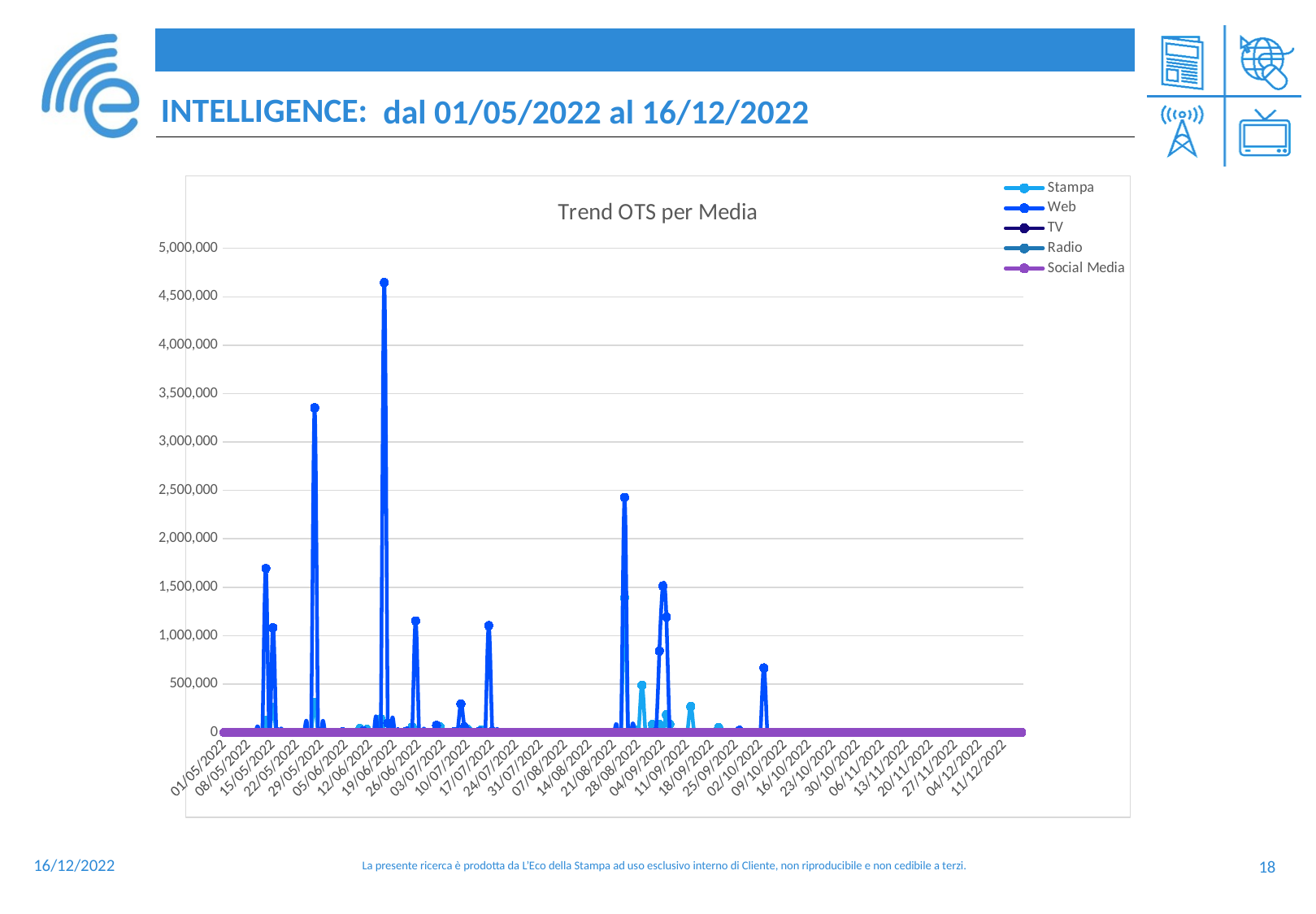
What is the title of the chart? Trend OTS per Media Is the highest peak of the Web series (around 19/06/2022) greater or less than 4,000,000? greater Is the Web peak around 28/08/2022 greater or less than 2,000,000? greater Is the Web peak around 22/05/2022 greater or less than 3,000,000? greater Which is larger: the Web peak around 19/06/2022 or the Web peak around 22/05/2022? the peak around 19/06/2022 How many series does the legend list? 5 What is the maximum value shown on the vertical axis? 5,000,000 Which series reaches the highest value on the chart? Web What kind of chart is shown on the slide? line chart Which series are listed in the chart legend? Stampa, Web, TV, Radio, Social Media